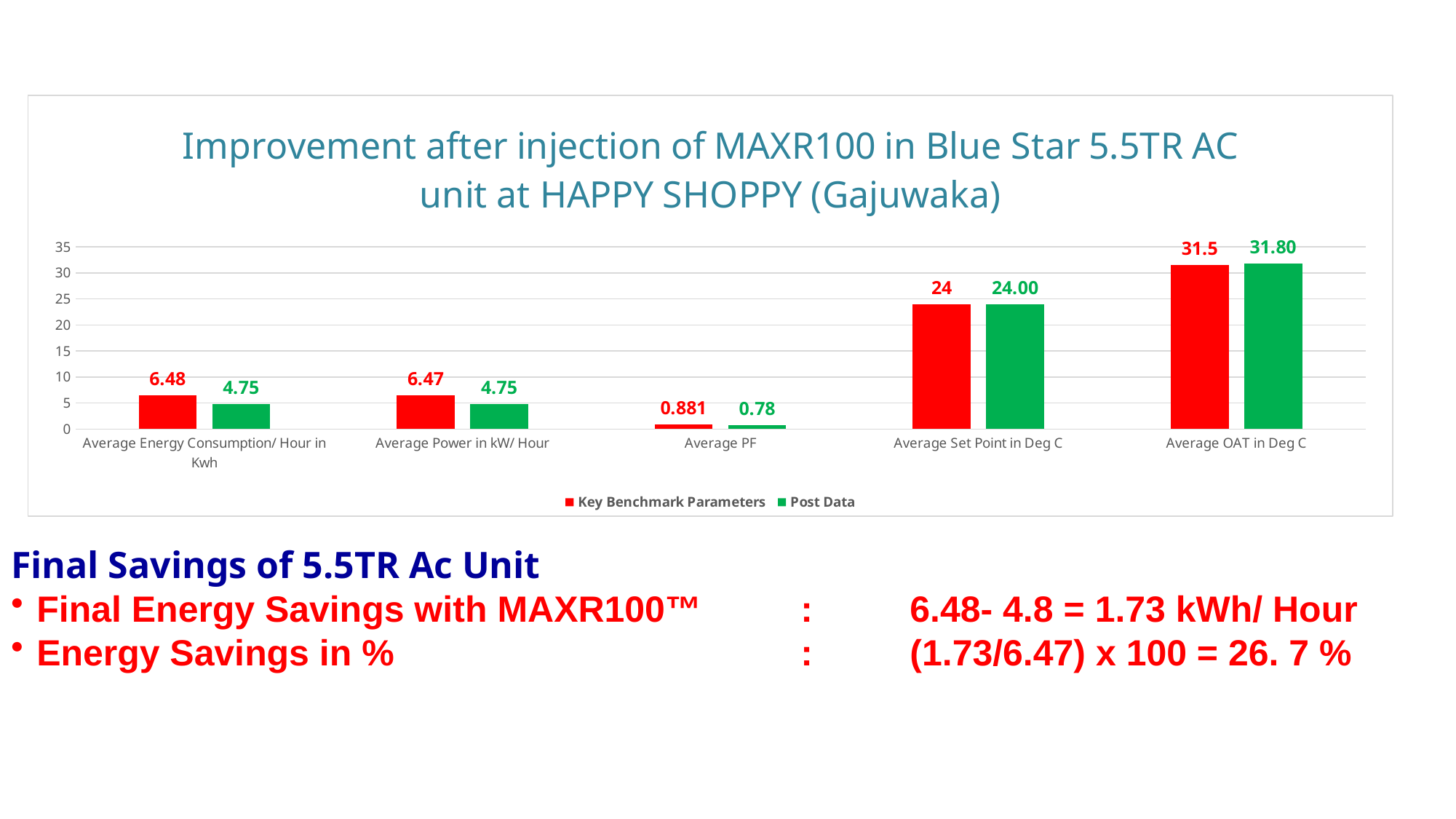
What is the Key Benchmark Parameters value for Average Energy Consumption/ Hour in Kwh? 6.48 How many series does the legend list? 2 What is the Key Benchmark Parameters value for Average OAT in Deg C? 31.5 What is the Post Data value for Average Power in kW/ Hour? 4.75 What kind of chart is shown on the slide? Bar chart What is the difference between the Key Benchmark Parameters and Post Data values for Average Energy Consumption/ Hour in Kwh? 1.73 How many categories are shown on the x axis? 5 What colour are the Post Data bars? Green Which category has the lowest Key Benchmark Parameters value? Average PF Which is larger for Average Power in kW/ Hour: the Key Benchmark Parameters value or the Post Data value? Key Benchmark Parameters Which category has the highest Post Data value? Average OAT in Deg C What is the Post Data value for Average PF? 0.78